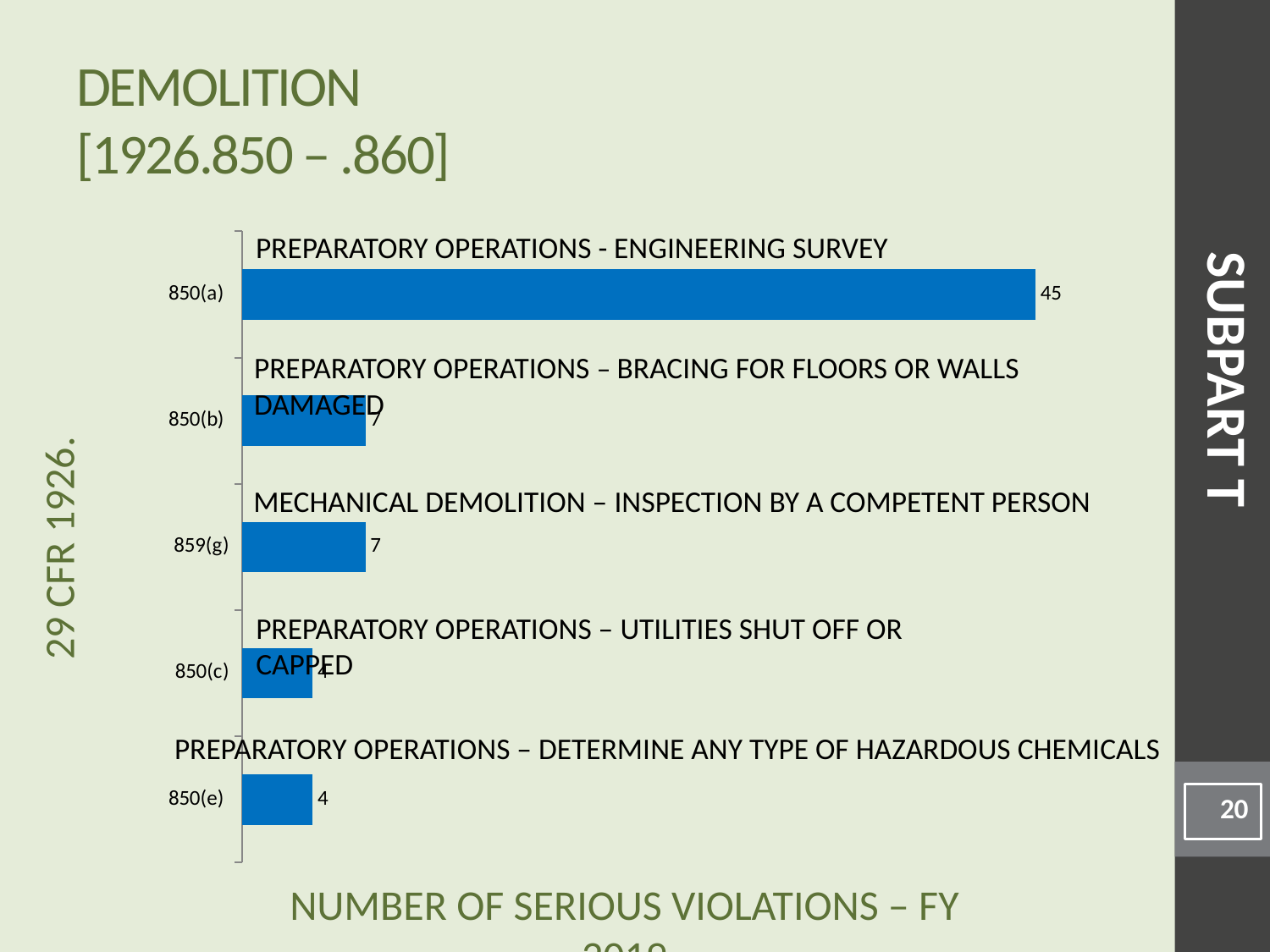
What is the difference between the values for 850(a) and 850(b)? 38 What is the number of serious violations for 850(b)? 7 What is the number of serious violations for 850(c)? 4 What is the lowest value shown in the chart? 4 What kind of chart is shown on the slide? Bar chart What colour are the bars in the chart? Blue Which has more serious violations, 850(a) or 859(g)? 850(a) Which category has the highest number of serious violations? 850(a) What is the number of serious violations for 850(a)? 45 What is the number of serious violations for 859(g)? 7 How many categories are shown in the chart? 5 What is the number of serious violations for 850(e)? 4